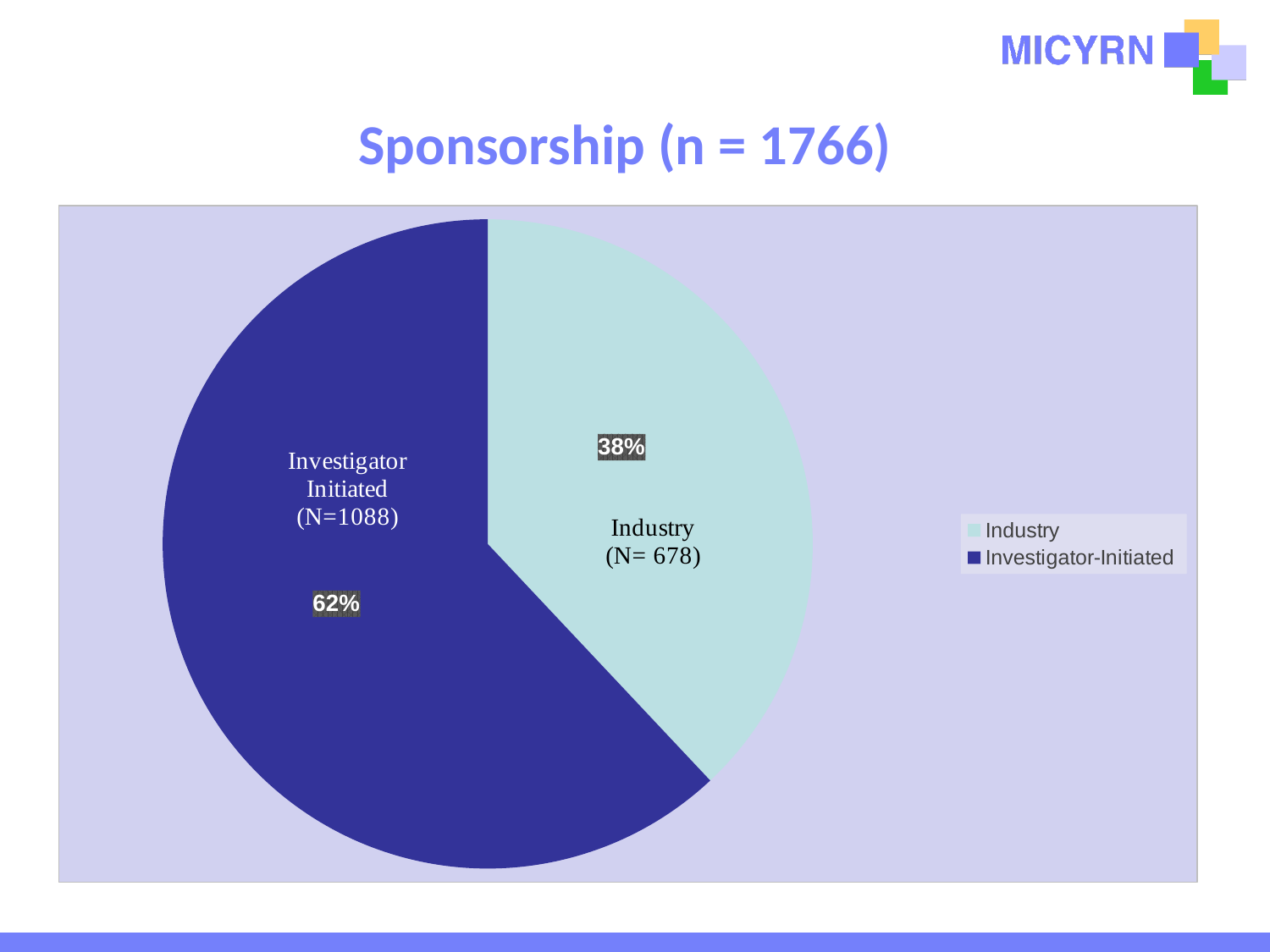
What is the difference in percentage points between the Investigator-Initiated and Industry slices? 24 What is the title of the chart on the slide? Sponsorship (n = 1766) How many slices does the pie chart have? 2 What is the N value shown for Investigator Initiated sponsorship? 1088 What percentage of the pie does the Investigator-Initiated slice represent? 62% What percentage of the pie does the Industry slice represent? 38% Which sponsorship category has the largest share of the pie? Investigator-Initiated What type of chart is shown on the slide? pie chart How many entries does the legend list? 2 What is the N value shown for Industry sponsorship? 678 Which is larger, the Industry slice or the Investigator-Initiated slice? Investigator-Initiated Which sponsorship category has the smallest share of the pie? Industry